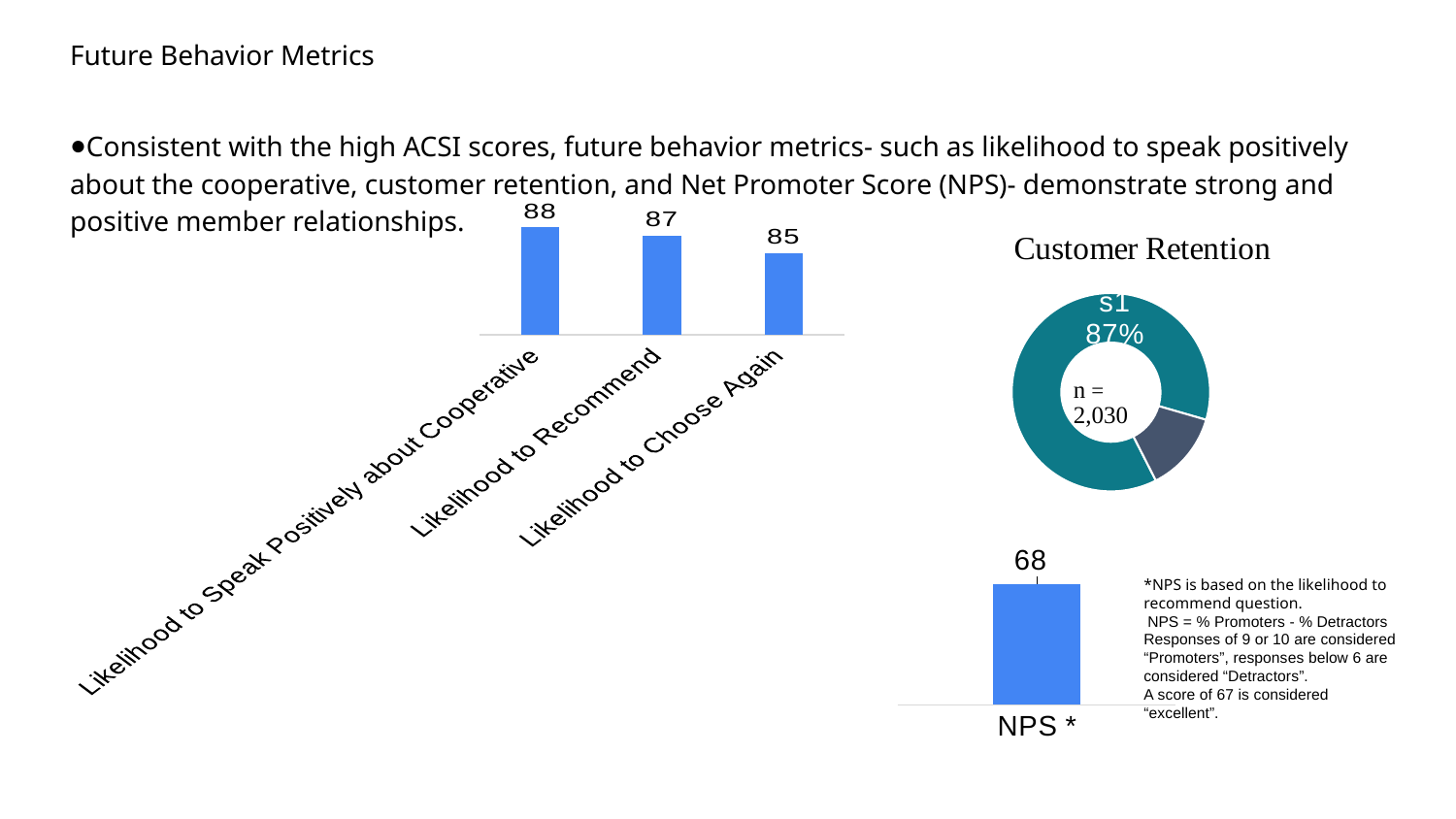
What kind of chart is the Customer Retention chart? doughnut chart In the NPS chart at the bottom right of the slide, what is the value for NPS *? 68 In the bar chart on the left of the slide, which category has the lowest value? Likelihood to Choose Again In the Customer Retention chart, what percentage is shown for the large teal slice? 87% In the bar chart on the left of the slide, what is the difference between the values for Likelihood to Speak Positively about Cooperative and Likelihood to Choose Again? 3 In the bar chart on the left of the slide, what is the value for Likelihood to Choose Again? 85 In the bar chart on the left of the slide, how many categories are shown? 3 In the bar chart on the left of the slide, which category has the highest value? Likelihood to Speak Positively about Cooperative In the bar chart on the left of the slide, what is the value for Likelihood to Recommend? 87 In the bar chart on the left of the slide, what is the value for Likelihood to Speak Positively about Cooperative? 88 In the bar chart on the left of the slide, do the values rise or fall from left to right? fall What kind of chart is the NPS chart at the bottom right of the slide? bar chart